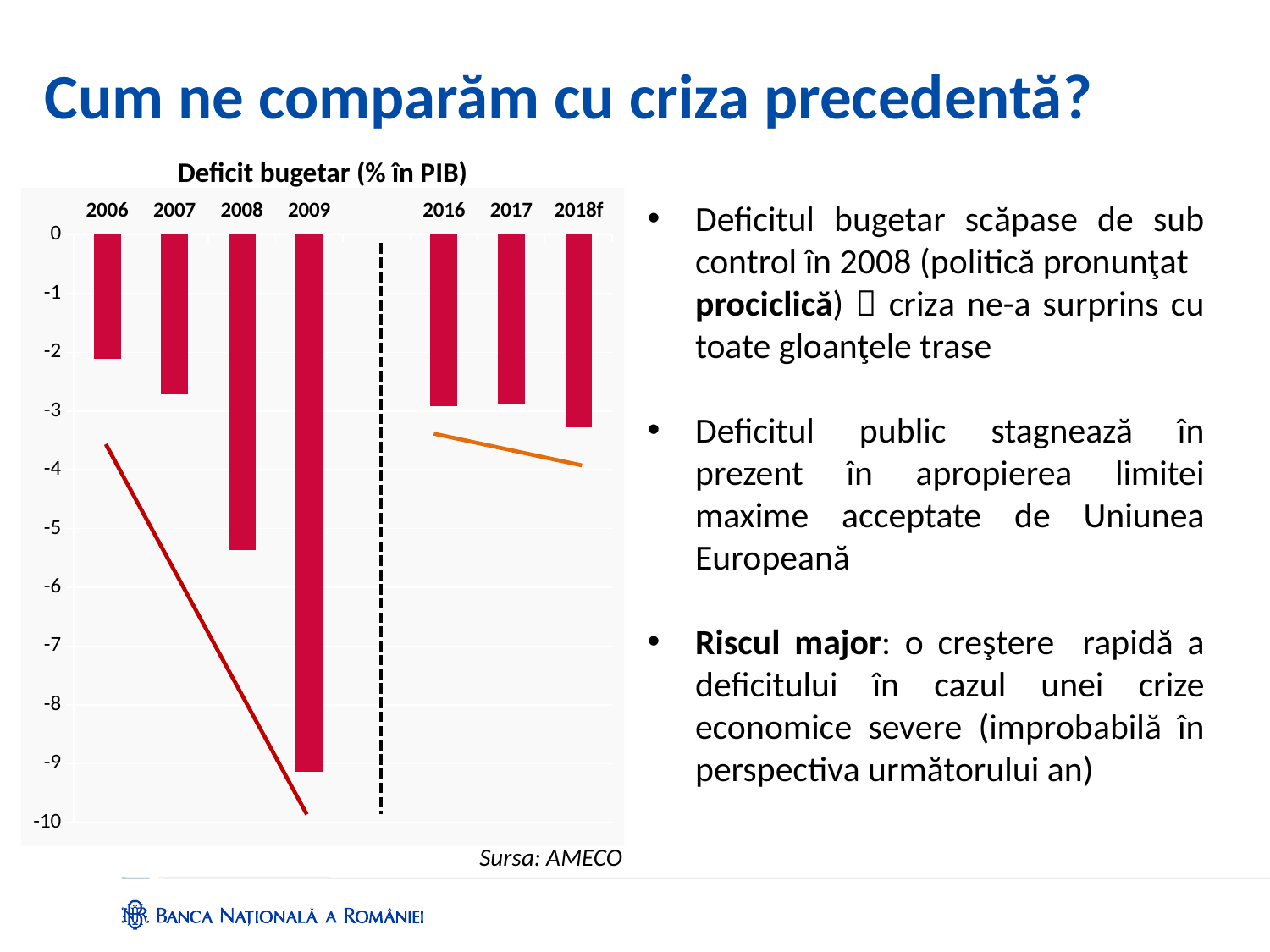
Which year has the highest value (smallest deficit) in the chart? 2006 Which year has a larger deficit, 2007 or 2008? 2008 Is the value for 2008 greater or less than -5? less What kind of chart is shown on the slide? bar chart What is the title of the chart? Deficit bugetar (% în PIB) Is the value for 2018f greater or less than -3? less How many years (bars) are plotted in the chart? 7 Is the value for 2009 greater or less than -8? less Which year has the lowest value (largest deficit) in the chart? 2009 Do the values rise or fall from 2006 to 2009? fall